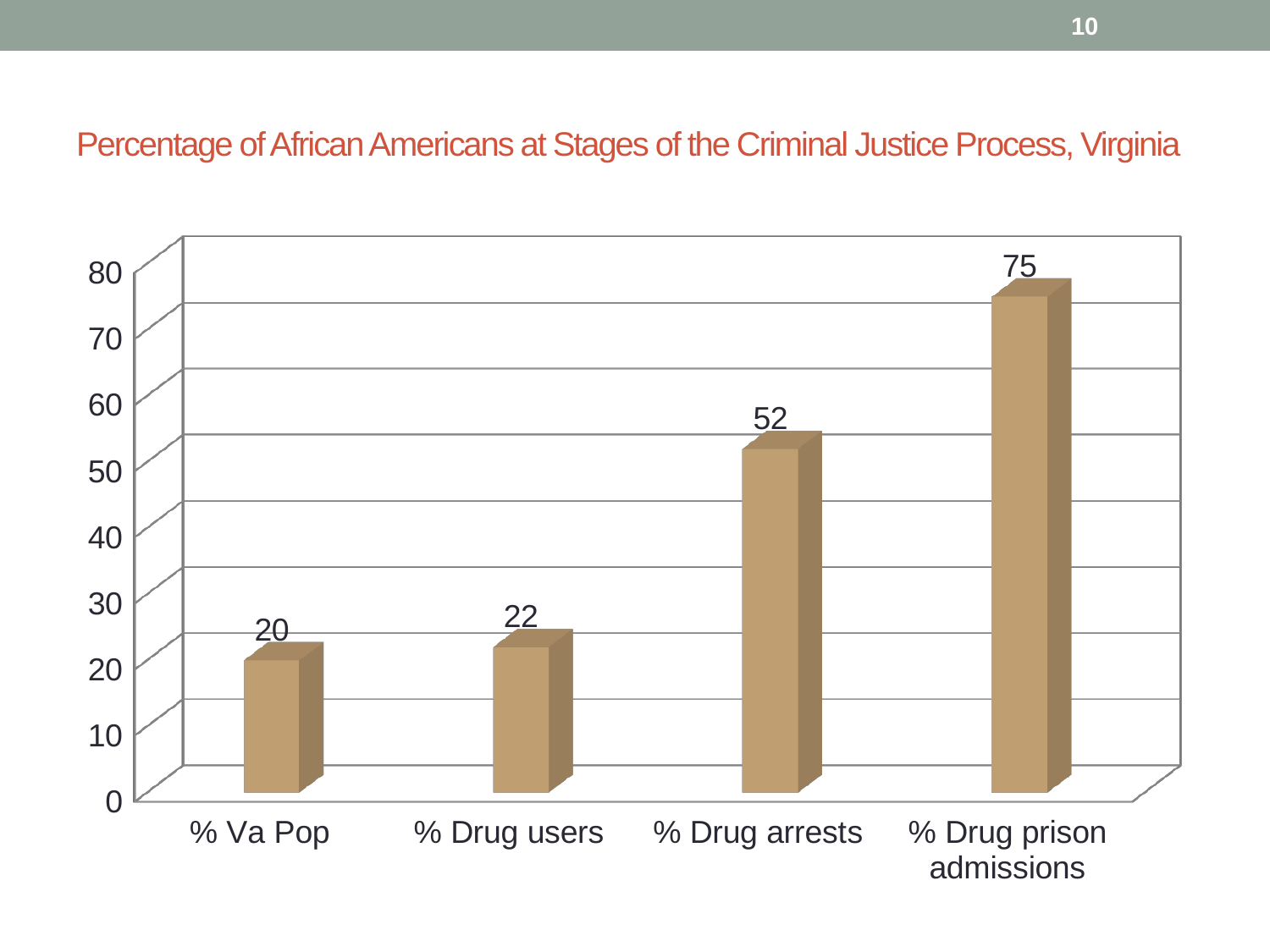
Do the values rise or fall from left to right along the x axis? Rise Which category has the highest value? % Drug prison admissions Which is larger, the value for % Drug arrests or the value for % Drug users? % Drug arrests What kind of chart is shown on the slide? Bar chart What is the difference between the values for % Drug arrests and % Drug users? 30 What is the value for % Drug arrests? 52 What is the value for % Drug prison admissions? 75 Which category has the lowest value? % Va Pop What is the value for % Va Pop? 20 How many categories are shown on the chart? 4 What is the difference between the values for % Drug prison admissions and % Drug arrests? 23 What is the value for % Drug users? 22